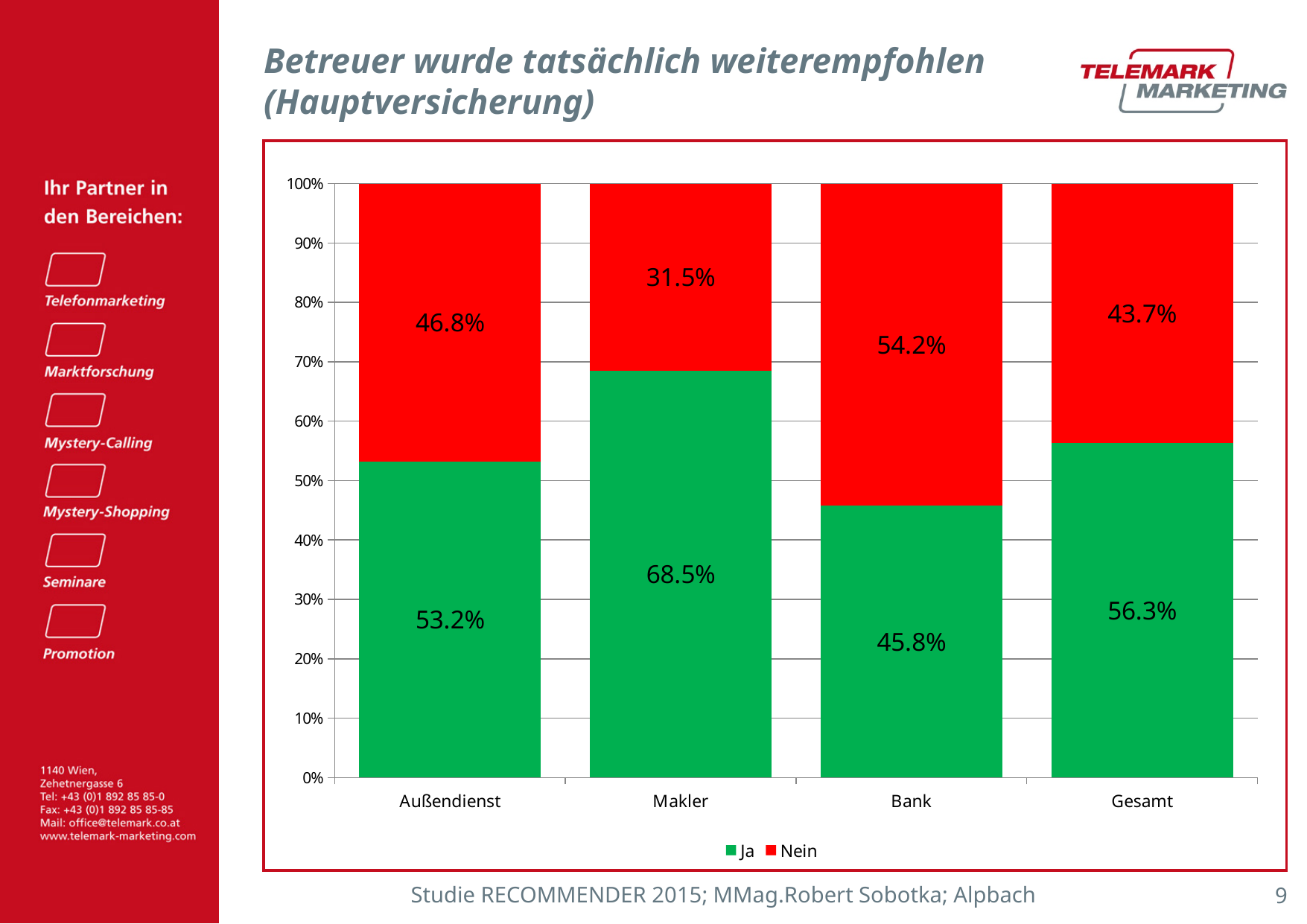
What is the 'Nein' value for Bank? 54.2% Which is larger: the 'Nein' value for Außendienst or the 'Nein' value for Gesamt? Außendienst What is the difference between the 'Ja' values for Makler and Bank? 22.7% What is the 'Ja' value for Gesamt? 56.3% Which category has the highest 'Ja' value? Makler What is the 'Nein' value for Außendienst? 46.8% What is the 'Ja' value for Makler? 68.5% How many categories are shown on the x axis? 4 Which category has the lowest 'Ja' value? Bank What kind of chart is shown on the slide? Stacked bar chart How many series does the legend list? 2 Which colour represents the 'Nein' series? Red